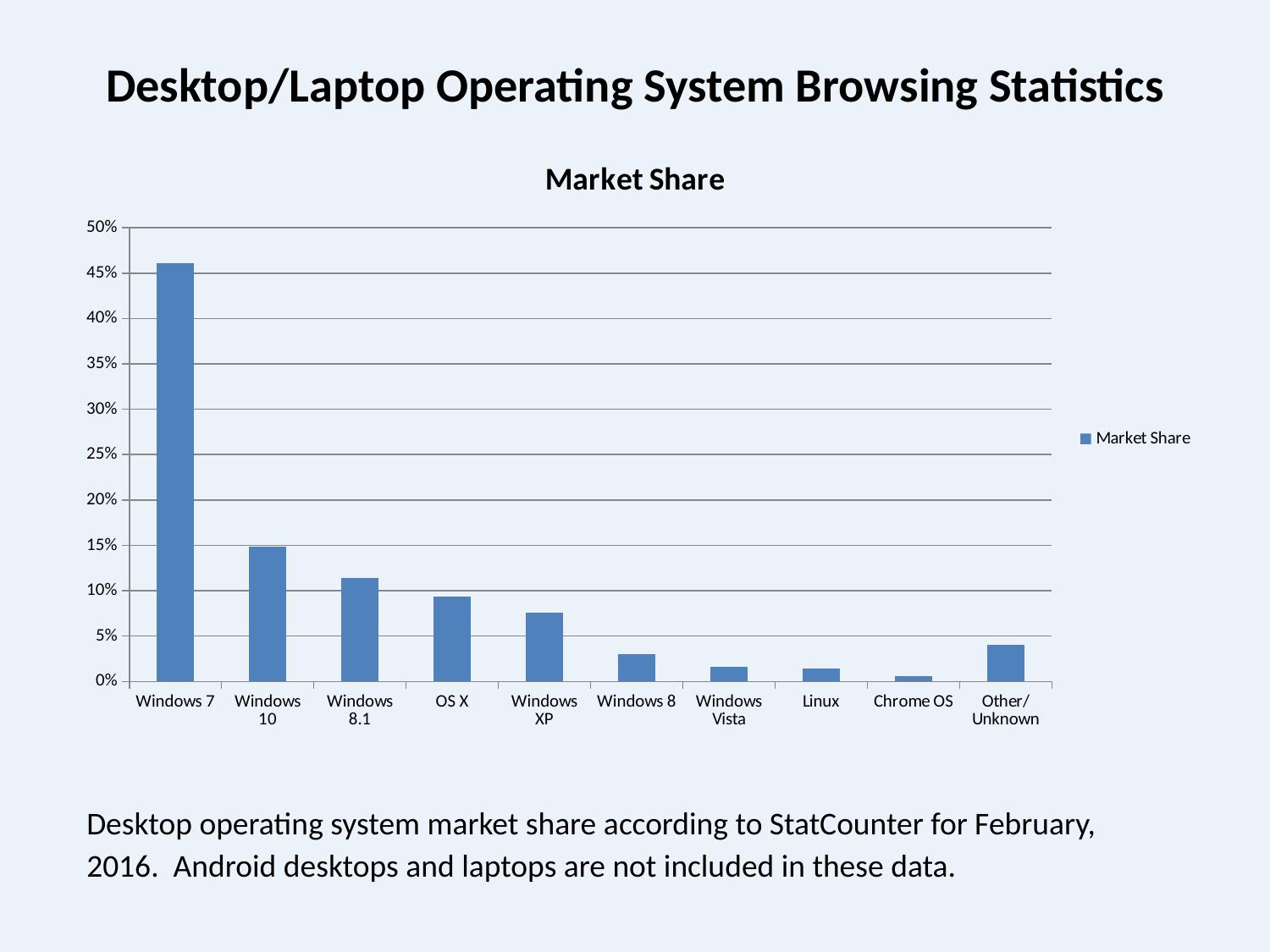
Which has a larger market share, Windows 10 or Windows 8.1? Windows 10 What type of chart is shown on the slide? Bar chart Is the market share for Windows 10 greater or less than 20%? less Which operating system has the highest market share in the chart? Windows 7 Which has a larger market share, OS X or Windows XP? OS X Which operating system has the lowest market share in the chart? Chrome OS Is the market share for Windows XP greater or less than 5%? greater Is the market share for Windows 8 greater or less than 5%? less What is the title of the chart? Market Share How many series does the legend list? 1 How many operating system categories are shown on the x axis? 10